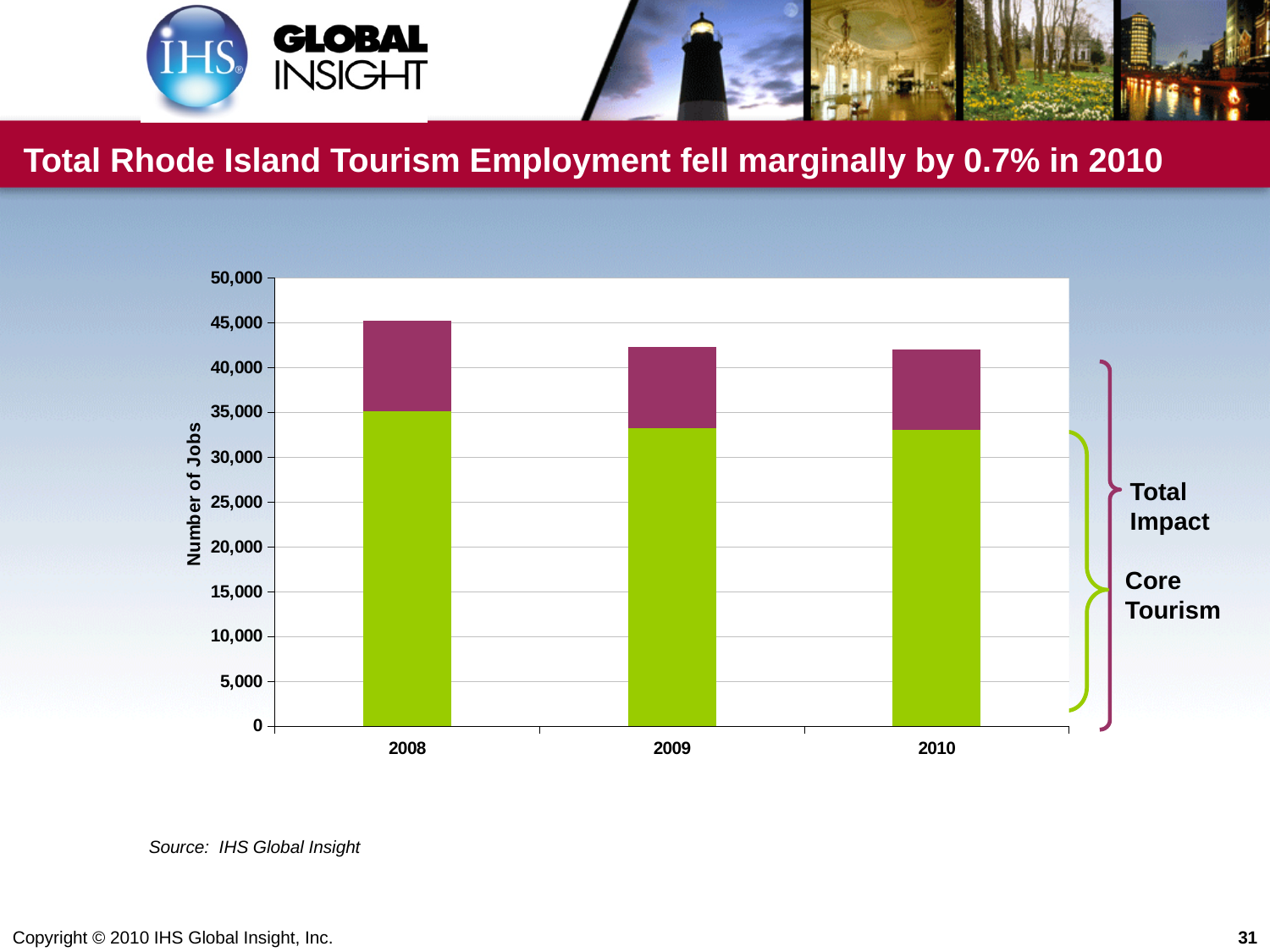
Is the total bar for 2009 greater or less than 40,000? greater Is the Core Tourism (green) portion for 2010 greater or less than 35,000? less Do the total bars rise or fall from 2008 to 2010? Fall Which is larger, the total bar for 2008 or the total bar for 2010? 2008 Which year has the tallest total bar in the chart? 2008 What kind of chart is shown on the slide? Stacked bar chart What is the label on the y axis of the chart? Number of Jobs Is the total bar for 2010 greater or less than 45,000? less Which segment of the stacked bars does the green colour represent? Core Tourism How many years are shown on the x axis of the chart? 3